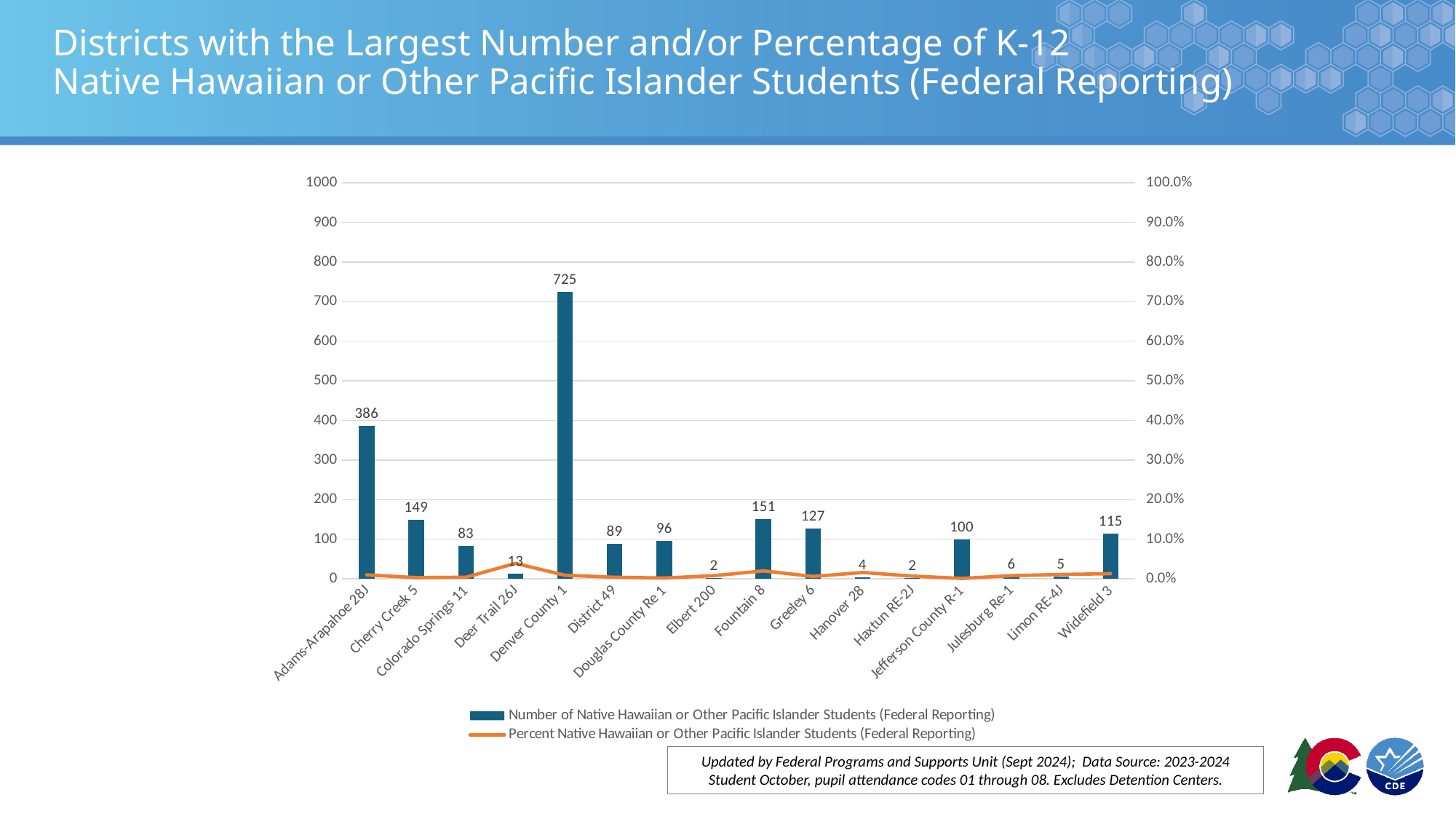
How many districts are shown on the x axis of the chart? 16 What is the number of Native Hawaiian or Other Pacific Islander students for Adams-Arapahoe 28J? 386 Which district has more students, Cherry Creek 5 or Jefferson County R-1? Cherry Creek 5 What is the difference in the number of students between Denver County 1 and Adams-Arapahoe 28J? 339 Which district has the highest number of Native Hawaiian or Other Pacific Islander students? Denver County 1 What is the number of students shown for Widefield 3? 115 Is the number of students for Douglas County Re 1 greater or less than 100? less What colour is the line representing the percent of Native Hawaiian or Other Pacific Islander students? Orange What is the difference in the number of students between Fountain 8 and Greeley 6? 24 What is the number of students shown for Deer Trail 26J? 13 How many series does the chart legend list? 2 How many Native Hawaiian or Other Pacific Islander students does Denver County 1 have? 725